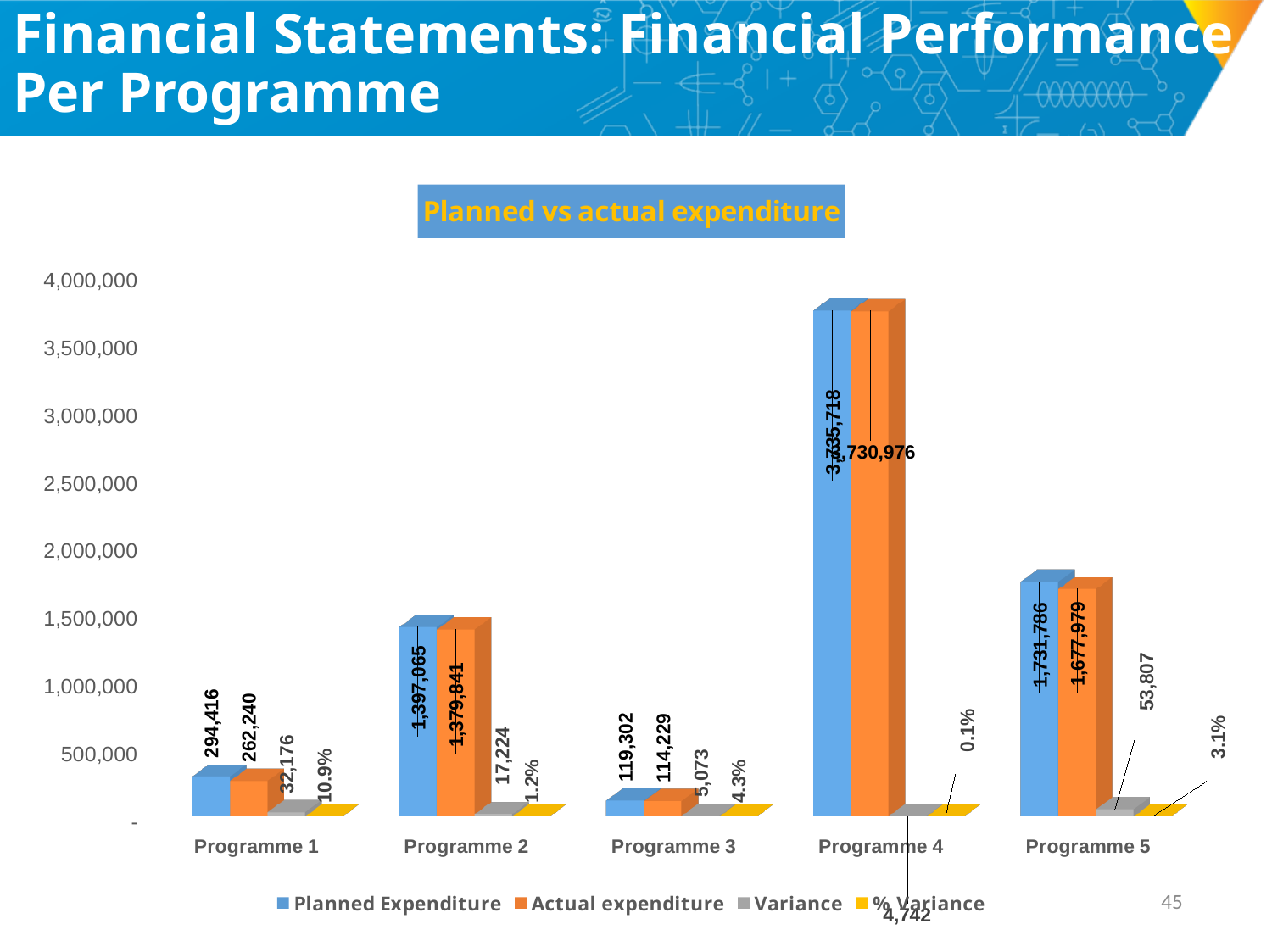
What kind of chart is shown on the slide? Bar chart What is the Variance for Programme 2? 17,224 How many series does the legend list? 4 What is the title of the chart? Planned vs actual expenditure What is the difference between Planned Expenditure and Actual expenditure for Programme 5? 53,807 What is the Actual expenditure for Programme 5? 1,677,979 Which is larger, the Variance for Programme 1 or the Variance for Programme 3? Programme 1 What is the % Variance for Programme 3? 4.3% What is the Planned Expenditure for Programme 1? 294,416 How many programmes are shown on the x axis? 5 Which programme has the lowest Actual expenditure? Programme 3 Which programme has the highest Planned Expenditure? Programme 4